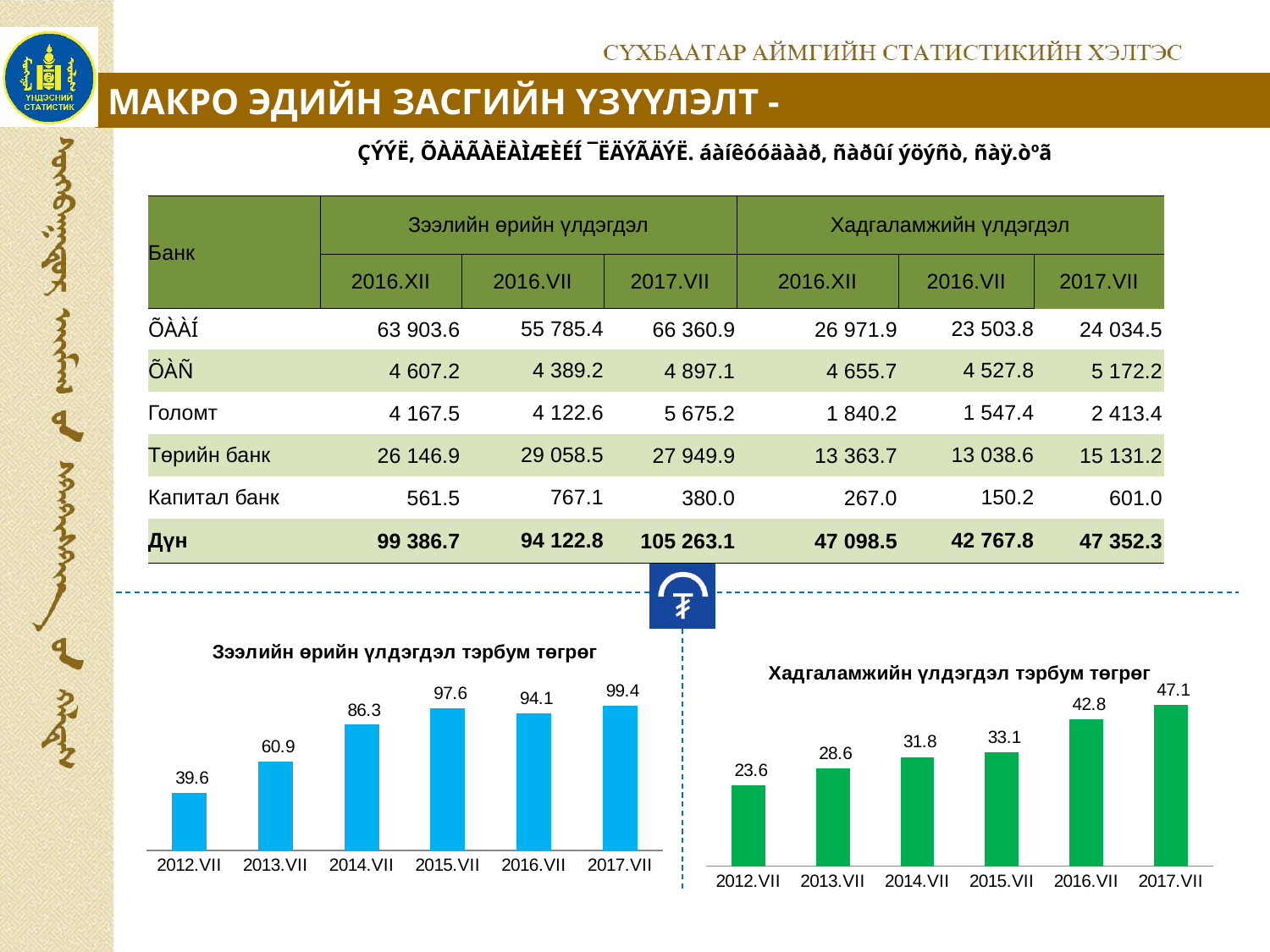
In the chart titled 'Хадгаламжийн үлдэгдэл тэрбум төгрөг', what is the value for 2016.VII? 42.8 In the chart titled 'Зээлийн өрийн үлдэгдэл тэрбум төгрөг', what is the value for 2017.VII? 99.4 In the chart titled 'Зээлийн өрийн үлдэгдэл тэрбум төгрөг', which period has the highest value? 2017.VII In the chart titled 'Зээлийн өрийн үлдэгдэл тэрбум төгрөг', what is the value for 2014.VII? 86.3 What type of chart is the chart titled 'Зээлийн өрийн үлдэгдэл тэрбум төгрөг'? bar chart What colour are the bars in the chart titled 'Хадгаламжийн үлдэгдэл тэрбум төгрөг'? green How many bars are shown in the chart titled 'Хадгаламжийн үлдэгдэл тэрбум төгрөг'? 6 In the chart titled 'Зээлийн өрийн үлдэгдэл тэрбум төгрөг', what is the difference between the values for 2013.VII and 2012.VII? 21.3 In the chart titled 'Хадгаламжийн үлдэгдэл тэрбум төгрөг', do the values rise or fall from 2012.VII to 2017.VII? rise In the chart titled 'Хадгаламжийн үлдэгдэл тэрбум төгрөг', which period has the lowest value? 2012.VII In the chart titled 'Зээлийн өрийн үлдэгдэл тэрбум төгрөг', which is larger: the value for 2015.VII or 2016.VII? 2015.VII In the chart titled 'Хадгаламжийн үлдэгдэл тэрбум төгрөг', what is the difference between the values for 2017.VII and 2016.VII? 4.3